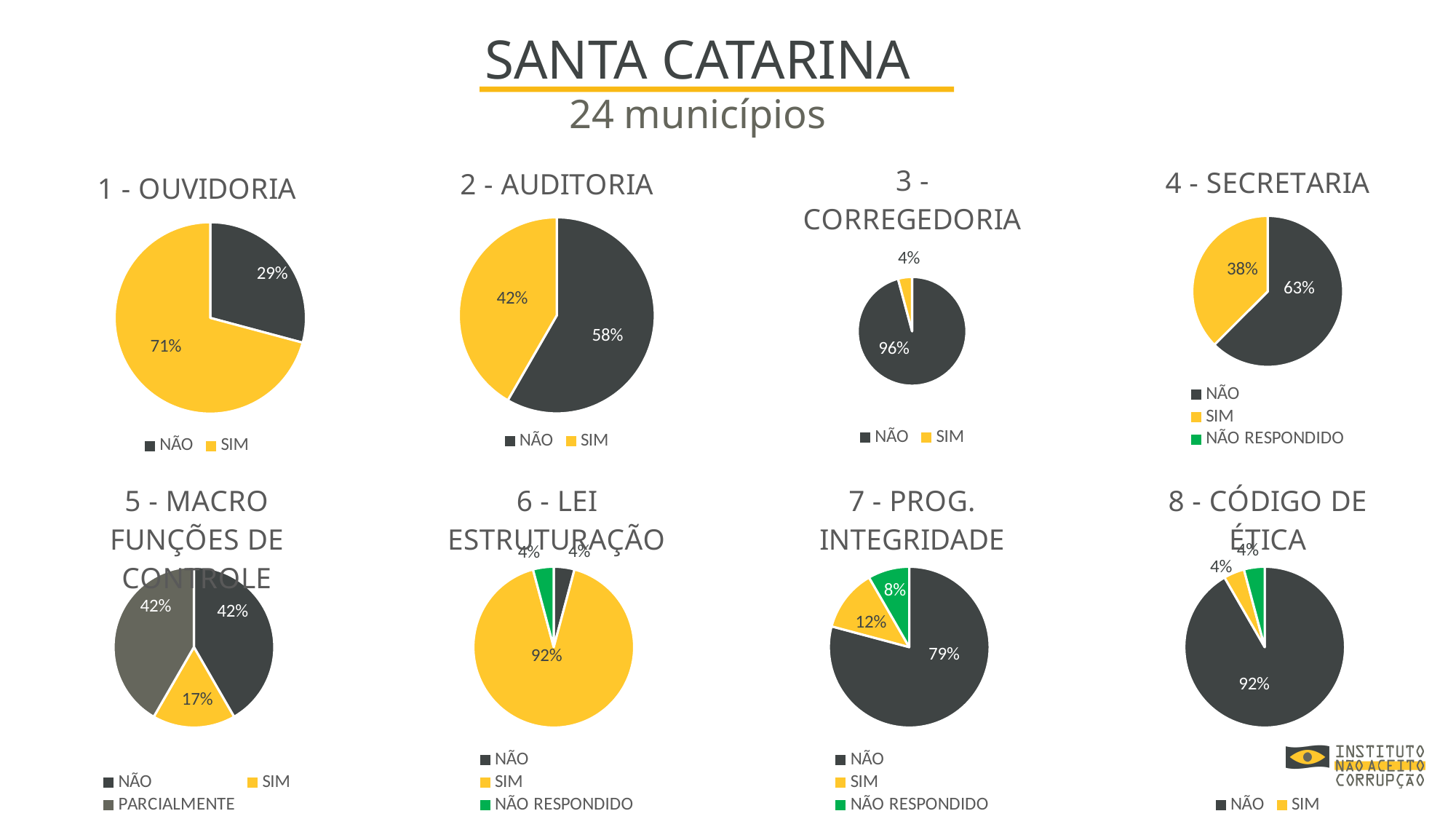
In the "7 - PROG. INTEGRIDADE" chart, which is larger, SIM or NÃO RESPONDIDO? SIM In the "3 - CORREGEDORIA" chart, which category has the largest share? NÃO In the "6 - LEI ESTRUTURAÇÃO" chart, what percentage is shown for SIM? 92% How many municipalities does the slide subtitle say are covered? 24 municípios In the "4 - SECRETARIA" chart, what is the difference between the NÃO and SIM percentages? 25% In the "7 - PROG. INTEGRIDADE" chart, what percentage is shown for NÃO RESPONDIDO? 8% In the "1 - OUVIDORIA" chart, what percentage is shown for SIM? 71% In the "5 - MACRO FUNÇÕES DE CONTROLE" chart, which category has the smallest share? SIM In the "5 - MACRO FUNÇÕES DE CONTROLE" chart, what percentage is shown for PARCIALMENTE? 42% In the "2 - AUDITORIA" chart, what percentage is shown for NÃO? 58% What type of chart is used for "8 - CÓDIGO DE ÉTICA"? Pie chart How many entries does the legend of the "7 - PROG. INTEGRIDADE" chart list? 3